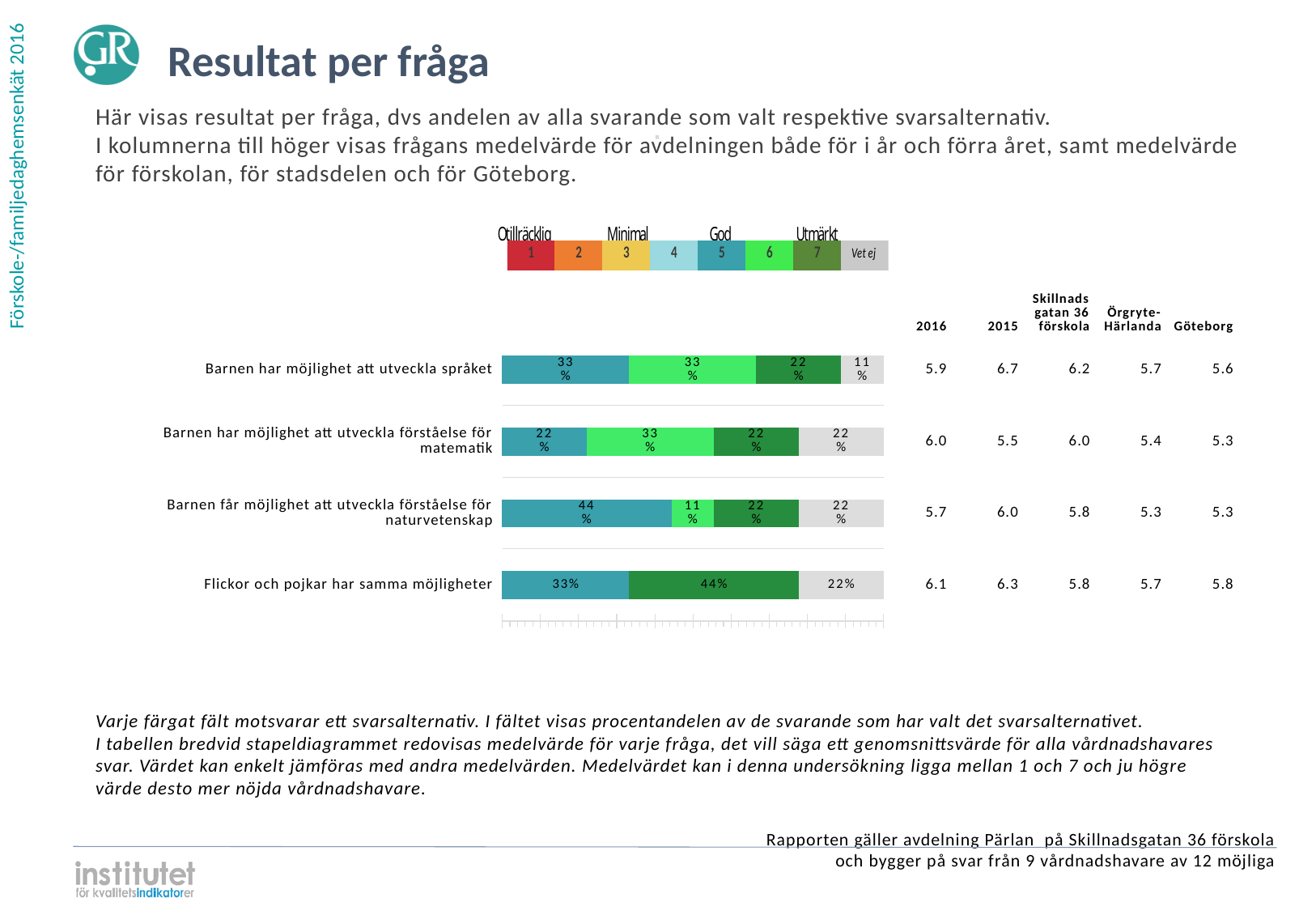
How many answer alternatives does the legend above the chart list? 8 What is the "Vet ej" share for "Barnen har möjlighet att utveckla språket"? 11% Which question has the largest share of respondents choosing answer 7 (dark green)? Flickor och pojkar har samma möjligheter What percentage of respondents chose answer 5 (teal) for "Barnen får möjlighet att utveckla förståelse för naturvetenskap"? 44% What percentage of respondents chose answer 7 (dark green) for "Flickor och pojkar har samma möjligheter"? 44% What kind of chart is shown on the slide? Stacked bar chart Is the answer 6 (light green) share larger for "Barnen har möjlighet att utveckla språket" or for "Barnen får möjlighet att utveckla förståelse för naturvetenskap"? Barnen har möjlighet att utveckla språket How many questions (bars) are shown in the chart? 4 Which question has the smallest "Vet ej" share? Barnen har möjlighet att utveckla språket What is the title of the slide? Resultat per fråga What percentage chose answer 6 (light green) for "Barnen har möjlighet att utveckla förståelse för matematik"? 33% What is the difference between the answer 5 share and the answer 6 share for "Barnen får möjlighet att utveckla förståelse för naturvetenskap"? 33 percentage points